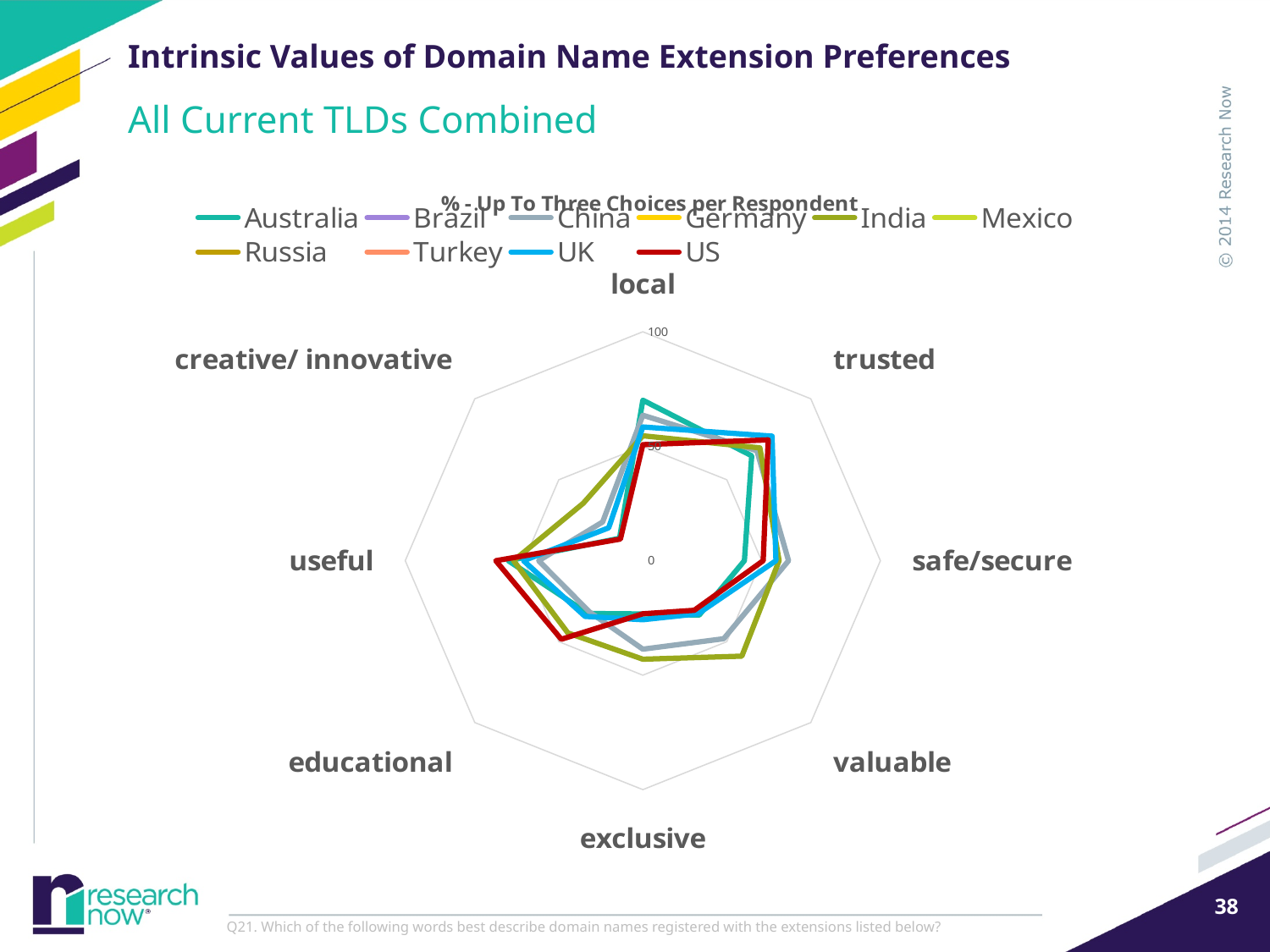
What is the title of the chart? % - Up To Three Choices per Respondent What is the maximum value shown on the radar chart's axis scale? 100 How many series does the legend list? 10 What kind of chart is shown on the slide? radar chart Is the value for the US on the 'useful' axis greater or less than 50? greater Is the value for the US on the 'exclusive' axis greater or less than 50? less Is the value for the US on the 'creative/ innovative' axis greater or less than 50? less How many categories (axes) does the radar chart have? 8 What colour is the line for the US series? red